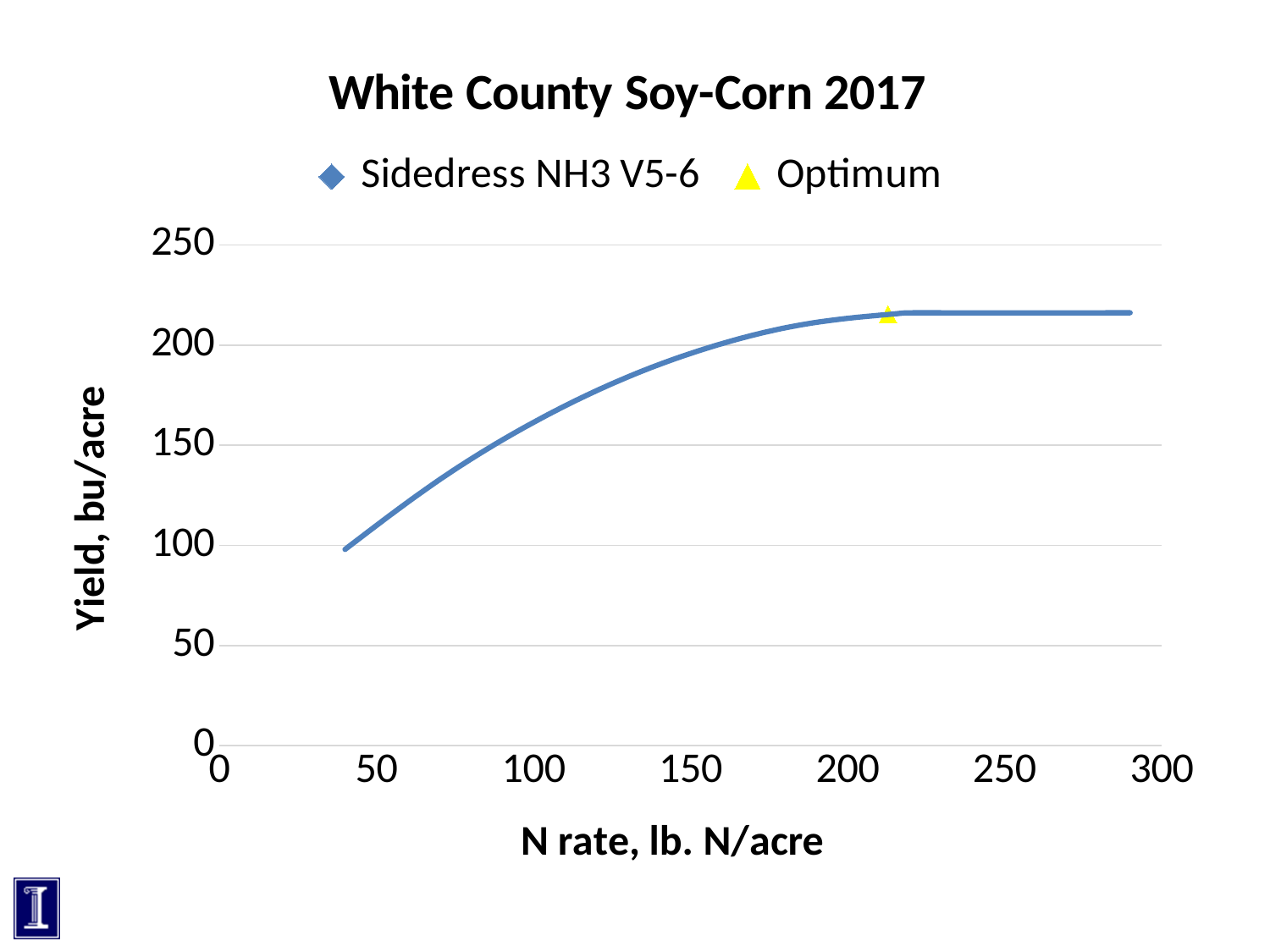
Is the yield for Sidedress NH3 V5-6 higher at an N rate of 100 or at an N rate of 200? 200 What is the label of the y axis? Yield, bu/acre Is the yield at the Optimum point greater or less than 200? greater Is the highest yield reached by the Sidedress NH3 V5-6 curve greater or less than 250? less How many series does the legend list? 2 Is the yield for Sidedress NH3 V5-6 at an N rate of 250 greater or less than 200? greater What is the title of the chart? White County Soy-Corn 2017 What kind of chart is shown on the slide? line chart Does the yield for Sidedress NH3 V5-6 rise or fall as the N rate increases from 50 to 200? rise